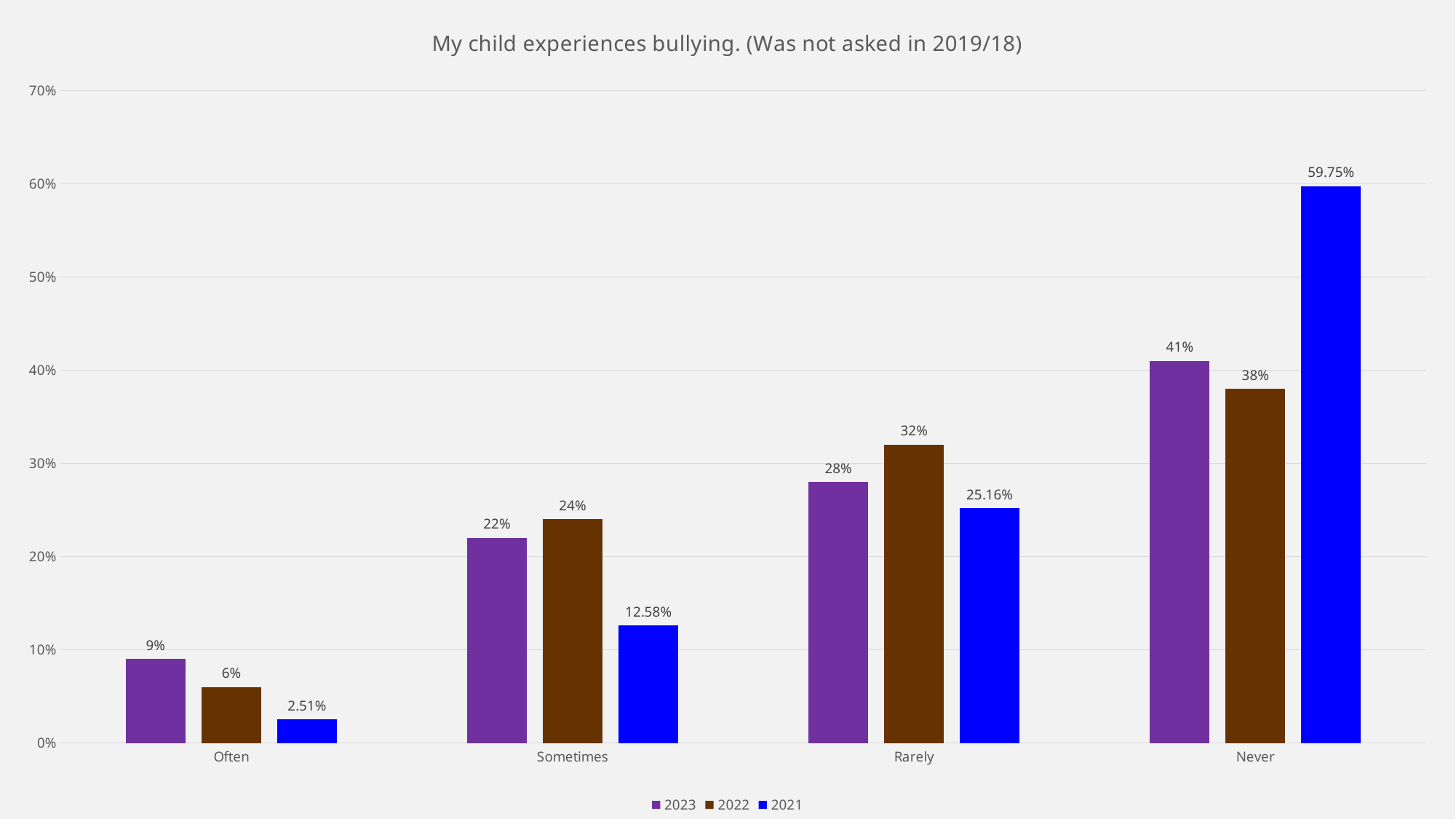
Is the value for 2021 in the Never category greater or less than 50%? greater What kind of chart is shown on the slide? bar chart What is the difference between the 2023 and 2022 values in the Never category? 3% Which category has the highest value for the 2023 series? Never How many series does the legend list? 3 What is the value for 2022 in the Rarely category? 32% How many categories are shown on the x axis? 4 What is the value for 2021 in the Never category? 59.75% Which category has the lowest value for the 2021 series? Often What is the value for 2021 in the Sometimes category? 12.58% Which is larger in the Rarely category, the 2023 value or the 2022 value? 2022 What is the value for 2023 in the Often category? 9%